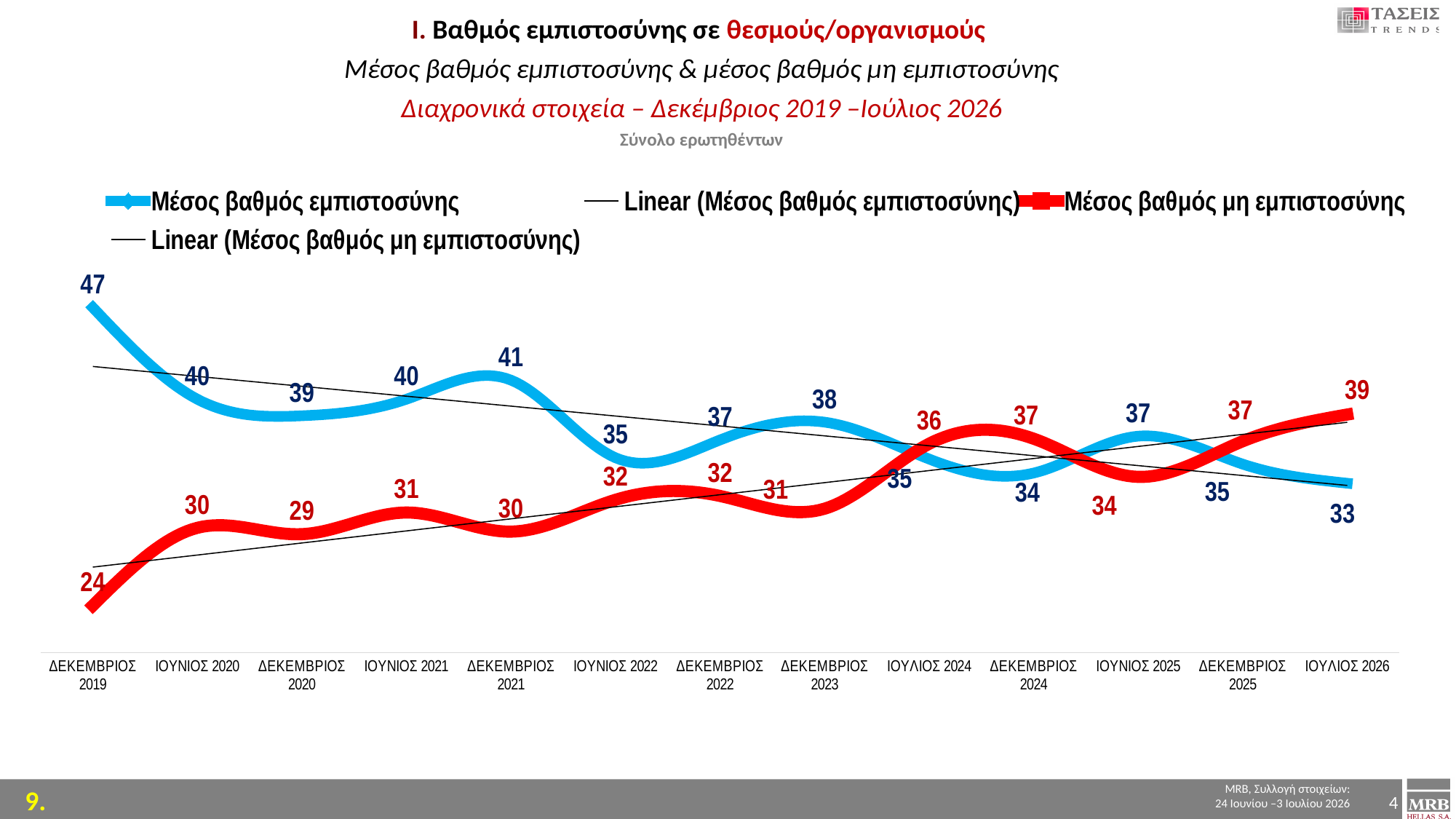
What is the value of Μέσος βαθμός εμπιστοσύνης in ΔΕΚΕΜΒΡΙΟΣ 2021? 41 What is the difference between Μέσος βαθμός εμπιστοσύνης and Μέσος βαθμός μη εμπιστοσύνης in ΔΕΚΕΜΒΡΙΟΣ 2019? 23 At which time point is Μέσος βαθμός μη εμπιστοσύνης lowest? ΔΕΚΕΜΒΡΙΟΣ 2019 What is the value of Μέσος βαθμός εμπιστοσύνης in ΔΕΚΕΜΒΡΙΟΣ 2019? 47 At which time point is Μέσος βαθμός εμπιστοσύνης highest? ΔΕΚΕΜΒΡΙΟΣ 2019 Does Μέσος βαθμός μη εμπιστοσύνης generally rise or fall from ΔΕΚΕΜΒΡΙΟΣ 2019 to ΙΟΥΛΙΟΣ 2026? rise How many entries does the legend list? 4 How many time points are plotted along the x axis? 13 What type of chart is shown on the slide? line chart What is the value of Μέσος βαθμός μη εμπιστοσύνης in ΙΟΥΛΙΟΣ 2026? 39 What colour is the line for Μέσος βαθμός μη εμπιστοσύνης? red In ΙΟΥΛΙΟΣ 2026, which is larger: Μέσος βαθμός εμπιστοσύνης or Μέσος βαθμός μη εμπιστοσύνης? Μέσος βαθμός μη εμπιστοσύνης